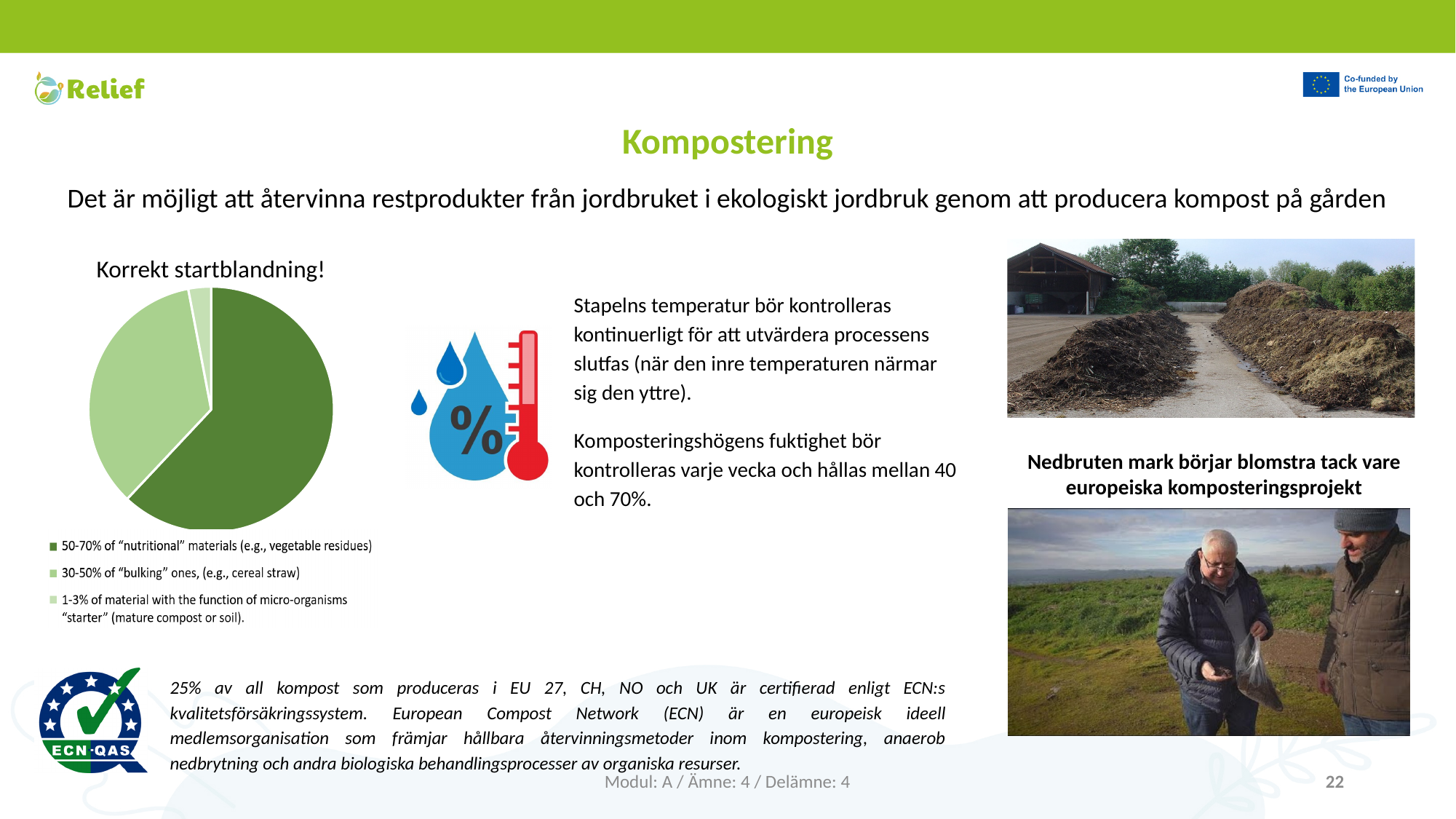
How many slices does the pie chart have? 3 Which category takes up the smallest slice of the pie chart? 1-3% of material with the function of micro-organisms "starter" (mature compost or soil) What is the title shown above the pie chart? Korrekt startblandning! Which slice is larger in the pie chart: the "bulking" ones or the micro-organisms "starter" material? 30-50% of "bulking" ones, (e.g., cereal straw) Which category takes up the largest slice of the pie chart? 50-70% of "nutritional" materials (e.g., vegetable residues) What colour is the largest slice of the pie chart? Dark green What kind of chart is shown under the heading "Korrekt startblandning!"? Pie chart Which slice is larger in the pie chart: the "nutritional" materials or the "bulking" ones? 50-70% of "nutritional" materials (e.g., vegetable residues) How many entries does the legend of the pie chart list? 3